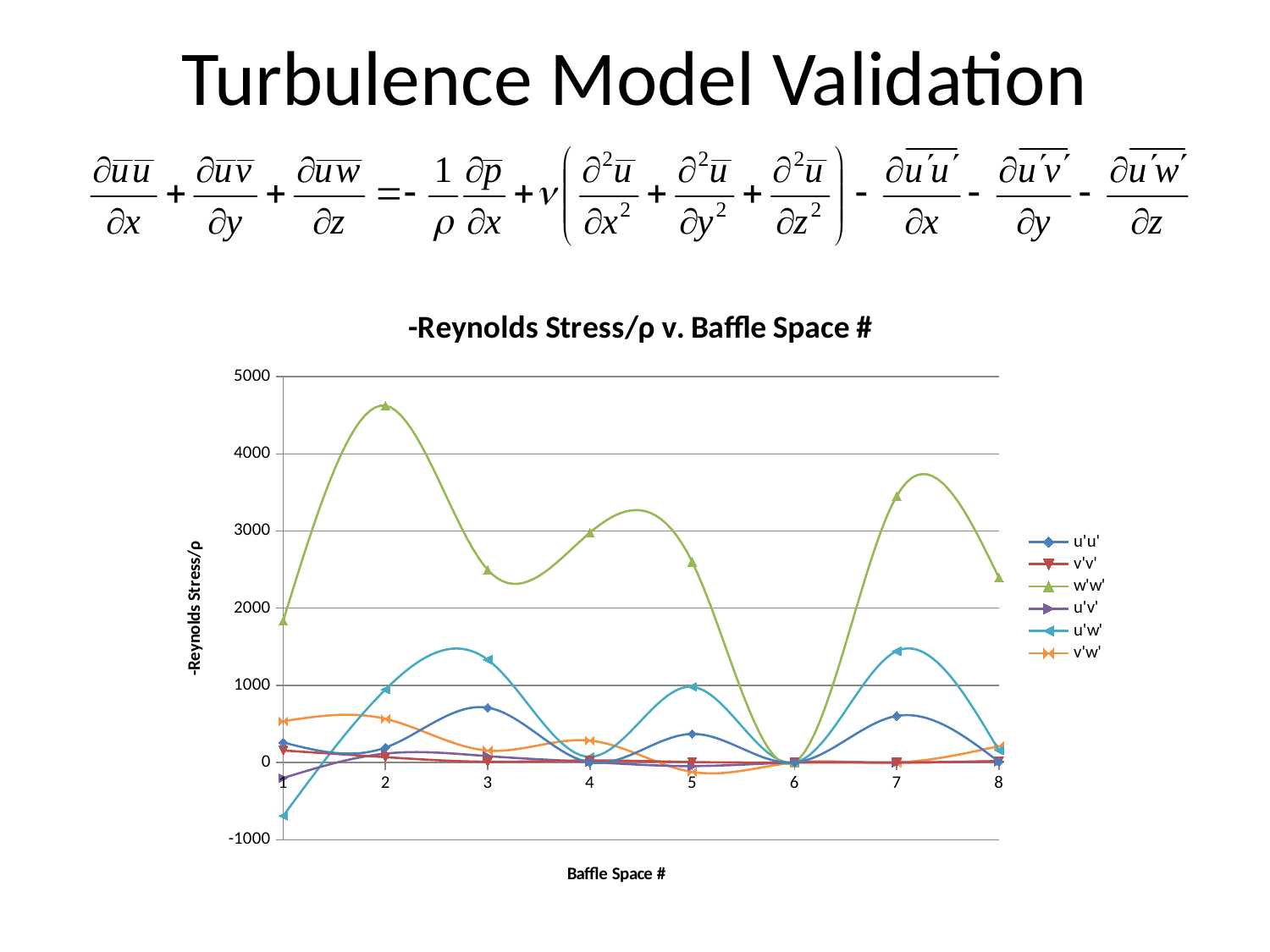
Is the value of u'w' at baffle space 1 greater or less than 0? less How many series does the legend list? 6 At baffle space 3, which series has the larger value, u'u' or u'w'? u'w' Is the value of w'w' at baffle space 2 greater or less than 4000? greater What is the title of the chart? -Reynolds Stress/ρ v. Baffle Space # Which series reaches the highest value anywhere on the chart? w'w' At which baffle space number does the w'w' series reach its lowest value? 6 How many baffle space numbers are plotted along the x axis? 8 At which baffle space number does the w'w' series reach its highest value? 2 Does the w'w' series rise or fall between baffle space 5 and baffle space 6? fall What kind of chart is shown on the slide? line chart Is the value of w'w' at baffle space 7 greater or less than 3000? greater